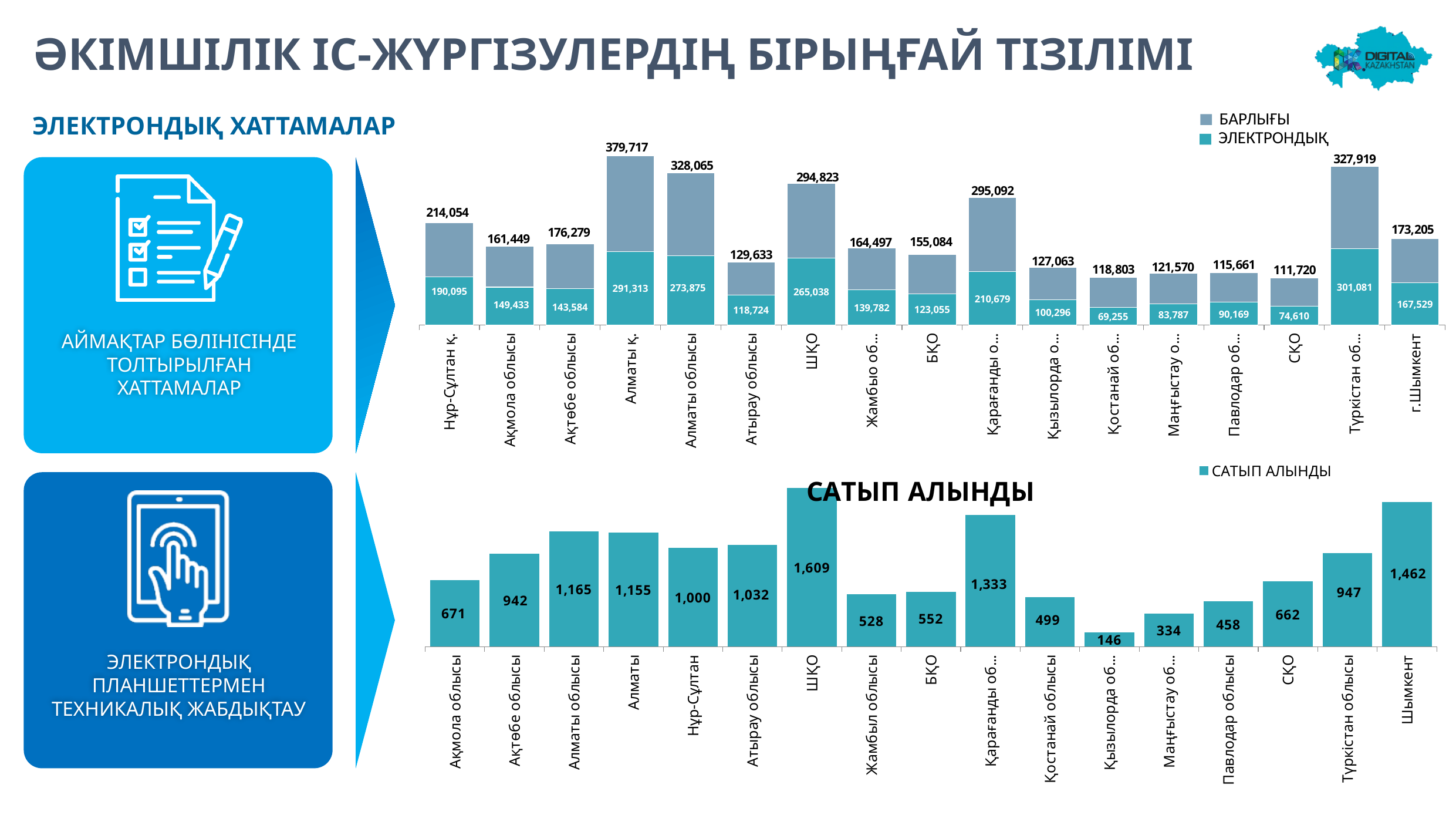
In the top chart (ЭЛЕКТРОНДЫҚ ХАТТАМАЛАР), which region has the lowest ЭЛЕКТРОНДЫҚ value? Қостанай об... In the top chart (ЭЛЕКТРОНДЫҚ ХАТТАМАЛАР), what is the БАРЛЫҒЫ value for Нұр-Сұлтан қ.? 214,054 In the top chart (ЭЛЕКТРОНДЫҚ ХАТТАМАЛАР), how many series does the legend list? 2 In the bottom chart (САТЫП АЛЫНДЫ), which region has the lowest value? Қызылорда об... In the bottom chart (САТЫП АЛЫНДЫ), which region has the highest value? ШҚО In the top chart (ЭЛЕКТРОНДЫҚ ХАТТАМАЛАР), what is the difference between the БАРЛЫҒЫ and ЭЛЕКТРОНДЫҚ values for г.Шымкент? 5,676 In the top chart (ЭЛЕКТРОНДЫҚ ХАТТАМАЛАР), what is the ЭЛЕКТРОНДЫҚ value for ШҚО? 265,038 In the top chart (ЭЛЕКТРОНДЫҚ ХАТТАМАЛАР), which is larger: the ЭЛЕКТРОНДЫҚ value for Алматы қ. or for Түркістан об...? Түркістан об... In the bottom chart (САТЫП АЛЫНДЫ), how many regions are shown on the x axis? 17 In the top chart (ЭЛЕКТРОНДЫҚ ХАТТАМАЛАР), which region has the highest БАРЛЫҒЫ value? Алматы қ. In the bottom chart (САТЫП АЛЫНДЫ), what is the difference between the values for Шымкент and Түркістан облысы? 515 In the bottom chart (САТЫП АЛЫНДЫ), what is the value for Қарағанды об...? 1,333